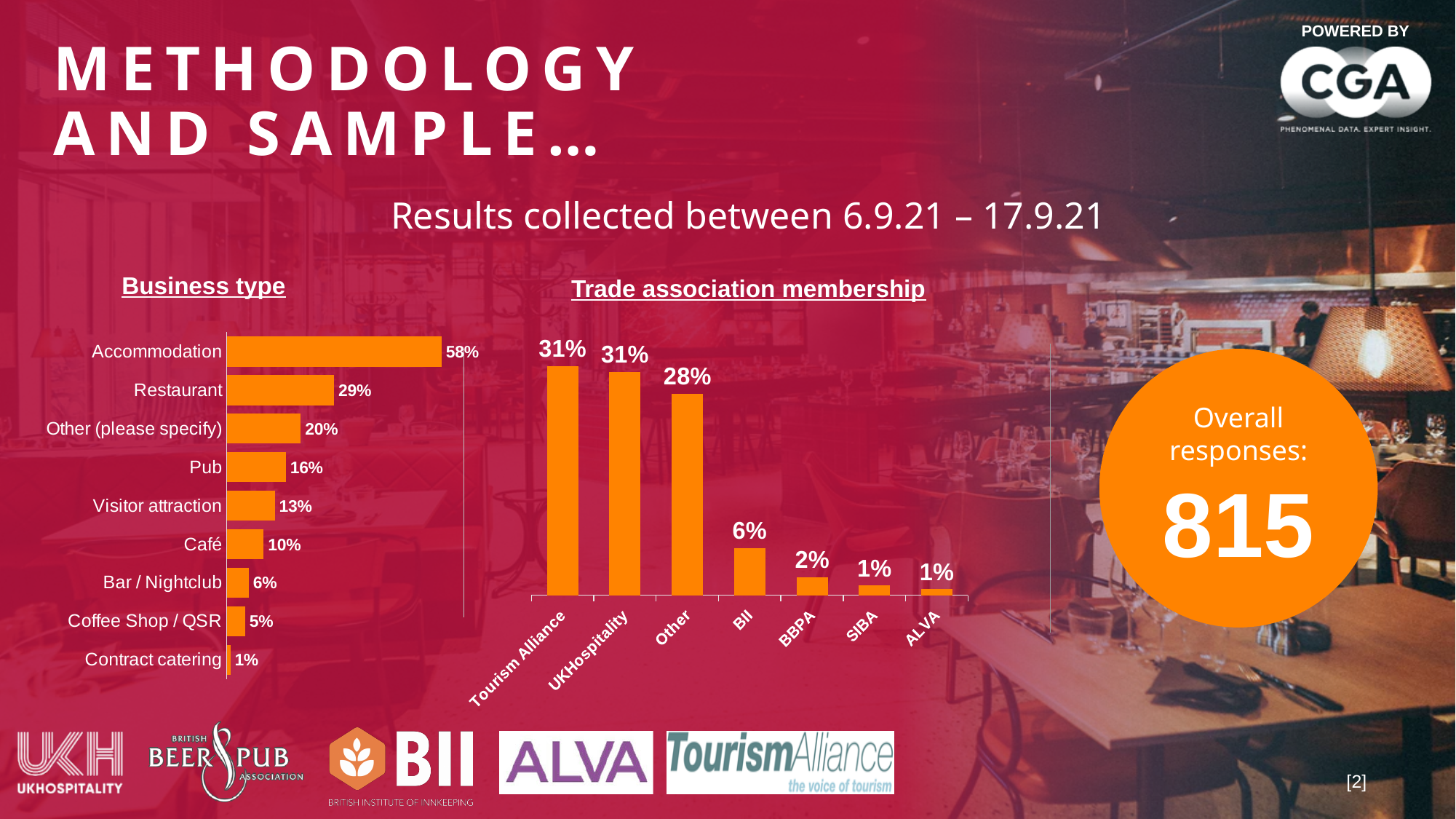
What type of chart is the Trade association membership chart? Bar chart In the Trade association membership chart, how many trade associations are shown? 7 In the Business type chart, which business type has the lowest percentage? Contract catering In the Business type chart, how many business types are listed? 9 In the Business type chart, which is larger, Visitor attraction or Bar / Nightclub? Visitor attraction In the Business type chart, what is the difference between Restaurant and Café? 19% In the Trade association membership chart, do the values rise or fall from left to right? Fall In the Trade association membership chart, what is the difference between Tourism Alliance and BBPA? 29% In the Trade association membership chart, what percentage is shown for Other? 28% In the Business type chart, what percentage is shown for Accommodation? 58% In the Trade association membership chart, what percentage is shown for BII? 6% In the Business type chart, what percentage is shown for Pub? 16%